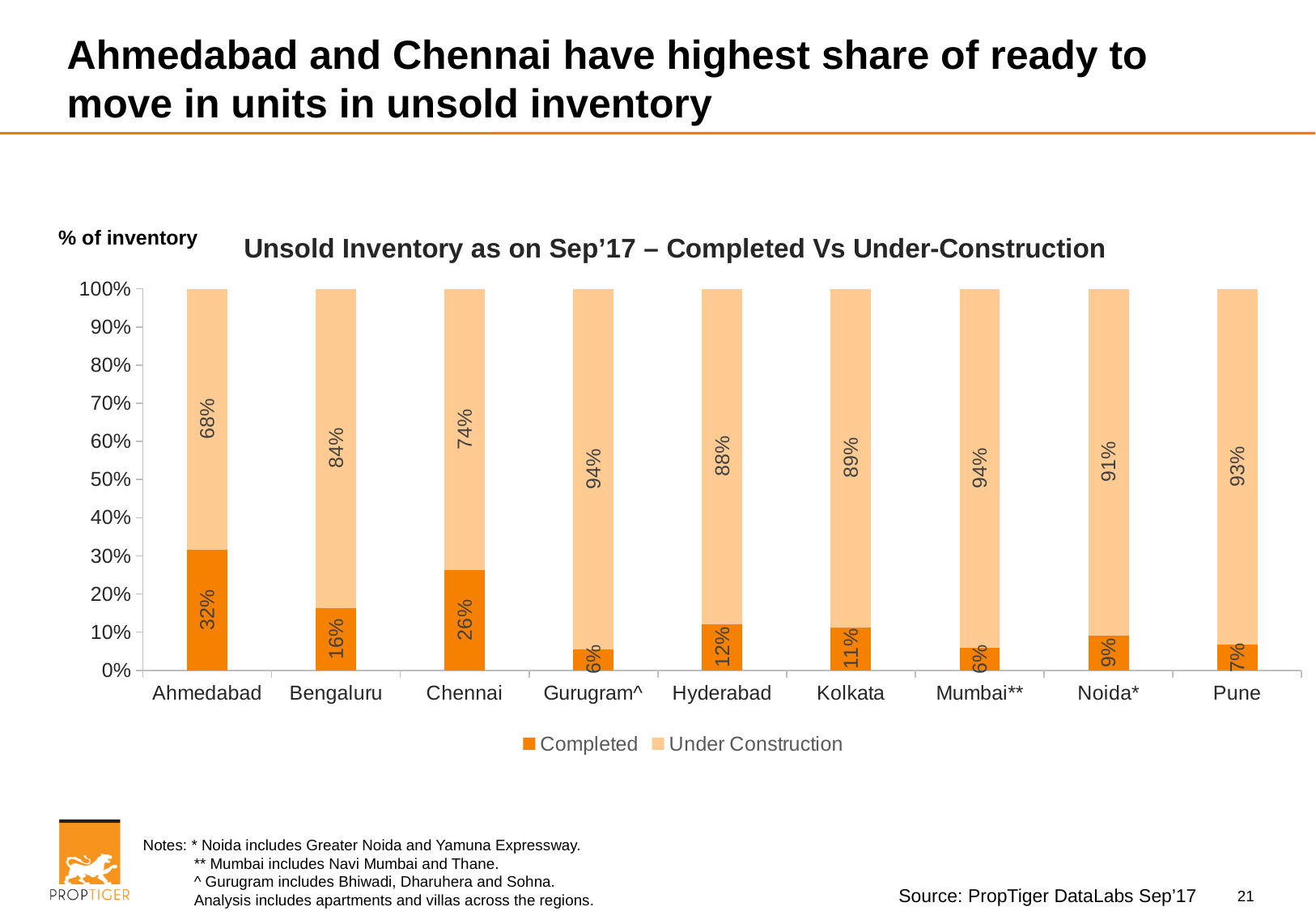
What is the total of the stacked bar for Pune? 100% What is the Completed share of unsold inventory for Ahmedabad? 32% What kind of chart is shown on the slide? Stacked bar chart What is the Completed share of unsold inventory for Noida*? 9% How many cities are shown on the x axis of the chart? 9 How many series does the legend list? 2 Which city has the lowest Under Construction share of unsold inventory? Ahmedabad What is the Under Construction share of unsold inventory for Hyderabad? 88% What is the difference between the Completed shares of Chennai and Bengaluru? 10% Which city has the highest Completed share of unsold inventory? Ahmedabad Which city has a larger Completed share, Hyderabad or Kolkata? Hyderabad What is the title of the chart? Unsold Inventory as on Sep’17 – Completed Vs Under-Construction